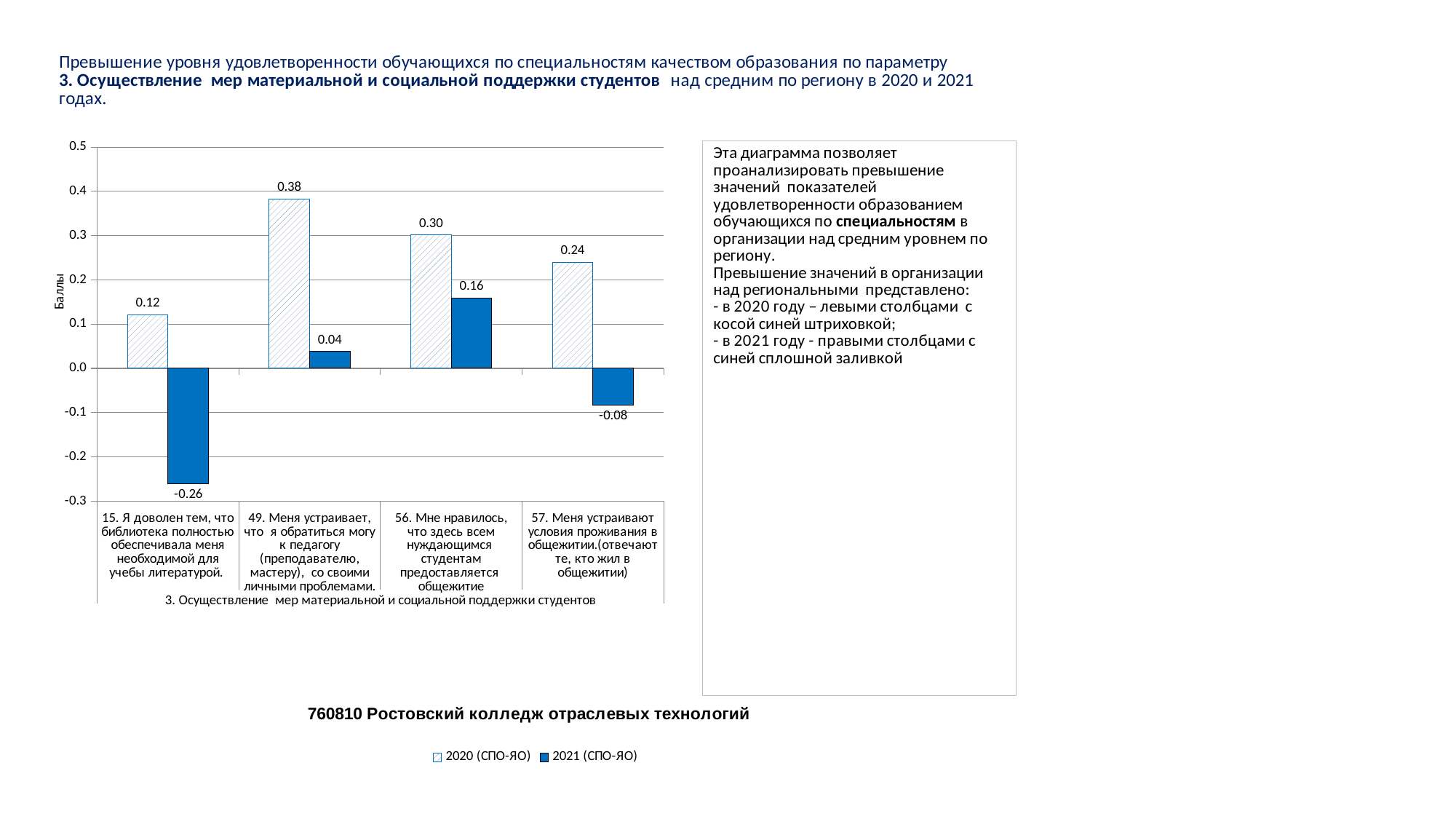
What is the label of the vertical axis of the chart? Баллы How many series does the legend list? 2 What is the 2020 (СПО-ЯО) value for question 49 (Меня устраивает, что я обратиться могу к педагогу)? 0.38 For question 49, which series has the larger value: 2020 (СПО-ЯО) or 2021 (СПО-ЯО)? 2020 (СПО-ЯО) What is the 2021 (СПО-ЯО) value for question 57 (Меня устраивают условия проживания в общежитии)? -0.08 Which category has the lowest 2021 (СПО-ЯО) value? 15. Я доволен тем, что библиотека полностью обеспечивала меня необходимой для учебы литературой. What is the 2021 (СПО-ЯО) value for question 15 (Я доволен тем, что библиотека полностью обеспечивала меня необходимой для учебы литературой)? -0.26 What type of chart is shown on the slide? bar chart How many categories (questions) are shown on the x axis of the chart? 4 Which category has the highest 2020 (СПО-ЯО) value? 49. Меня устраивает, что я обратиться могу к педагогу (преподавателю, мастеру), со своими личными проблемами. Which college is named in the caption below the chart? 760810 Ростовский колледж отраслевых технологий What is the difference between the 2020 and 2021 values for question 56 (Мне нравилось, что здесь всем нуждающимся студентам предоставляется общежитие)? 0.14